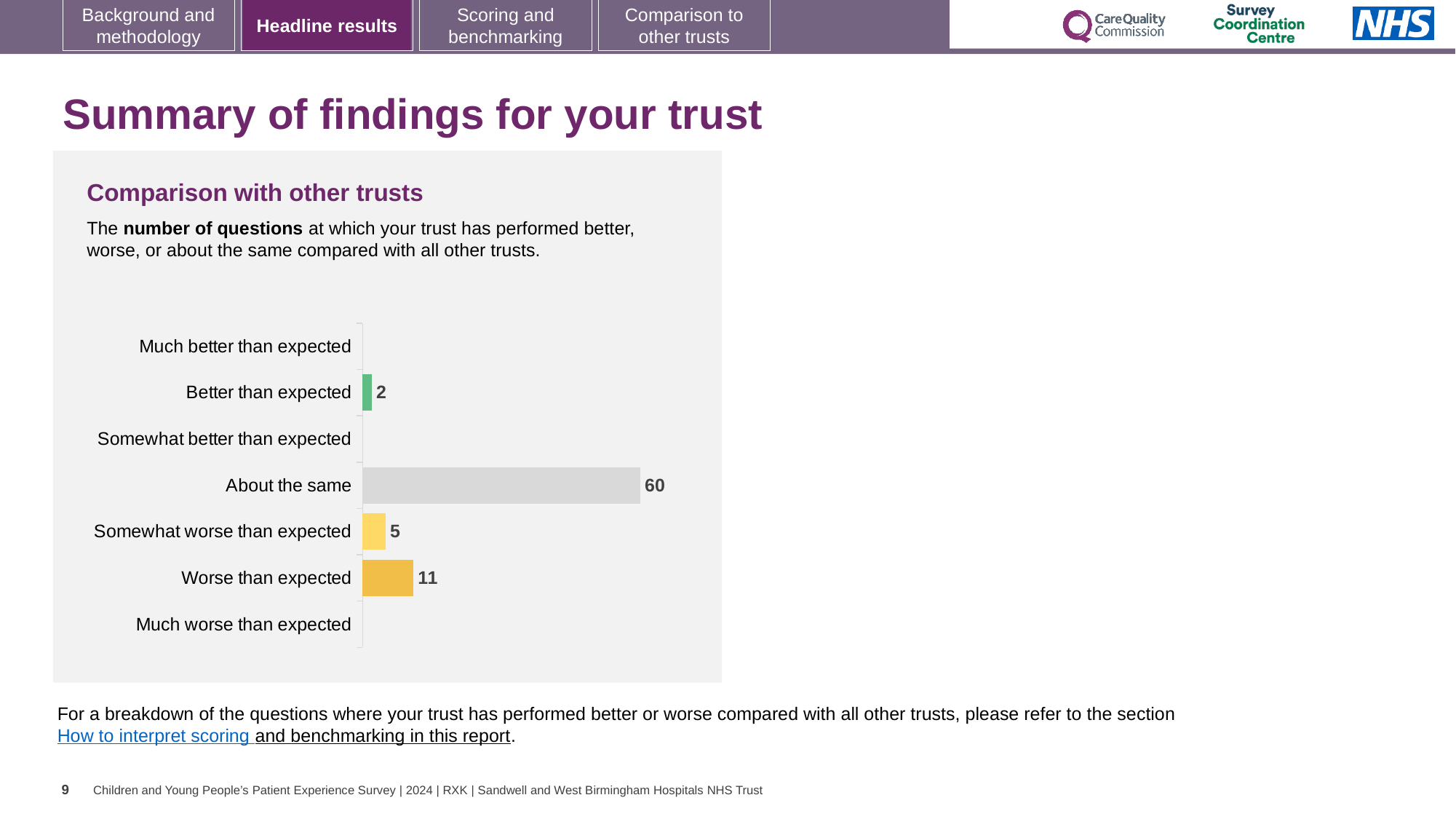
What is the number of questions for 'About the same'? 60 What is the title of the chart section? Comparison with other trusts What kind of chart is shown on the slide? Bar chart Which category has the highest number of questions? About the same What is the difference between the number of questions for 'About the same' and 'Worse than expected'? 49 What is the difference between the number of questions for 'Worse than expected' and 'Somewhat worse than expected'? 6 What is the number of questions for 'Worse than expected'? 11 How many categories are listed on the chart's axis? 7 Which is larger: the value for 'Worse than expected' or 'Better than expected'? Worse than expected What is the number of questions for 'Better than expected'? 2 What is the number of questions for 'Somewhat worse than expected'? 5 What colour is the bar for 'Better than expected'? Green